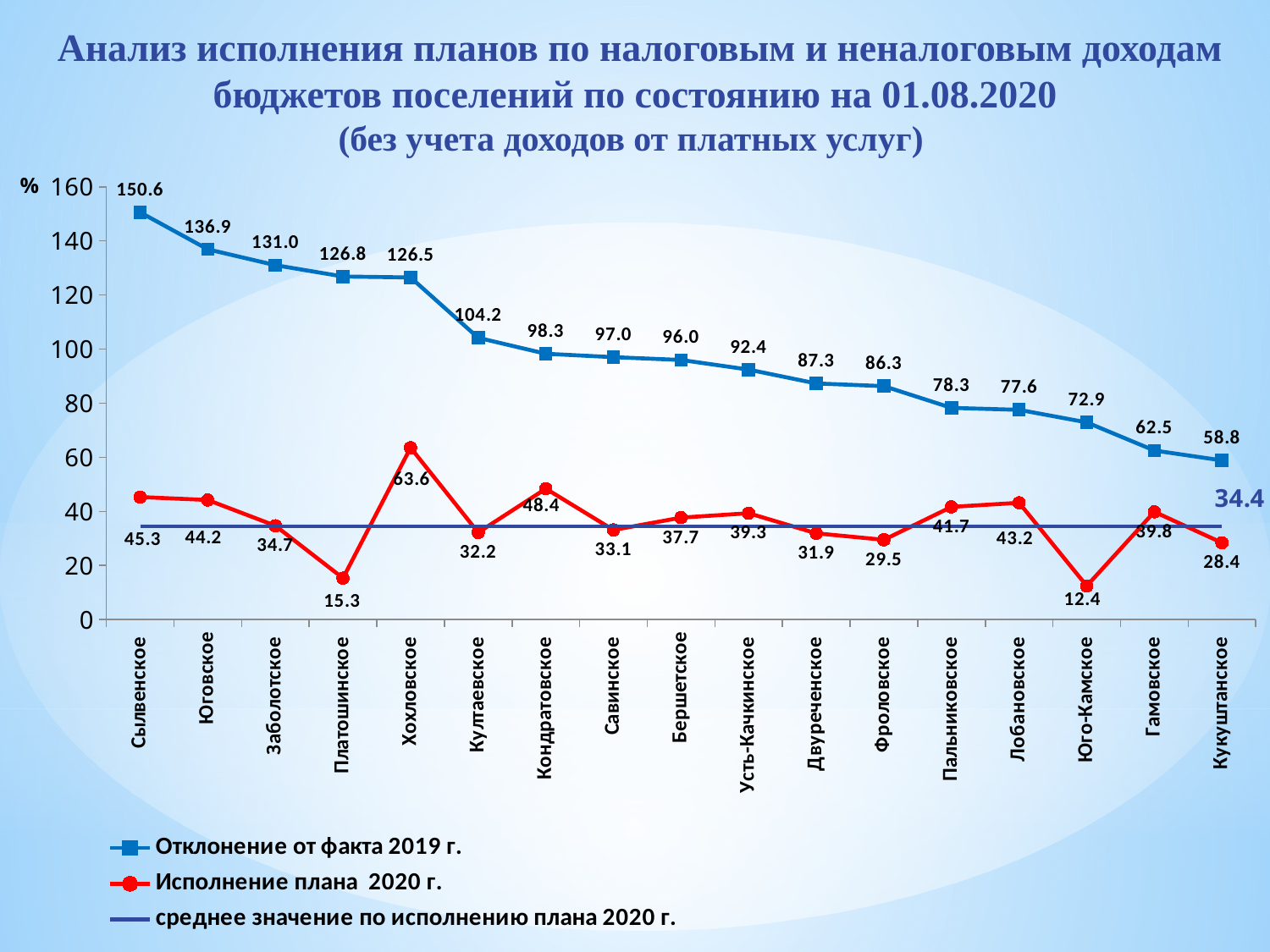
How many series does the legend list? 3 What is the difference between the 'Отклонение от факта 2019 г.' values for Сылвенское and Юговское? 13.7 Which settlement has the highest value for 'Исполнение плана 2020 г.'? Хохловское Does the 'Отклонение от факта 2019 г.' series rise or fall from left to right along the x axis? fall What type of chart is shown on the slide? line chart What is the value of 'Отклонение от факта 2019 г.' for Сылвенское? 150.6 How many settlements are plotted along the x axis? 17 What is the average value of 'Исполнение плана 2020 г.' shown by the horizontal line? 34.4 Which is larger: 'Исполнение плана 2020 г.' for Кондратовское or for Савинское? Кондратовское Which settlement has the lowest value for 'Отклонение от факта 2019 г.'? Кукуштанское What is the value of 'Исполнение плана 2020 г.' for Хохловское? 63.6 What is the value of 'Исполнение плана 2020 г.' for Юго-Камское? 12.4